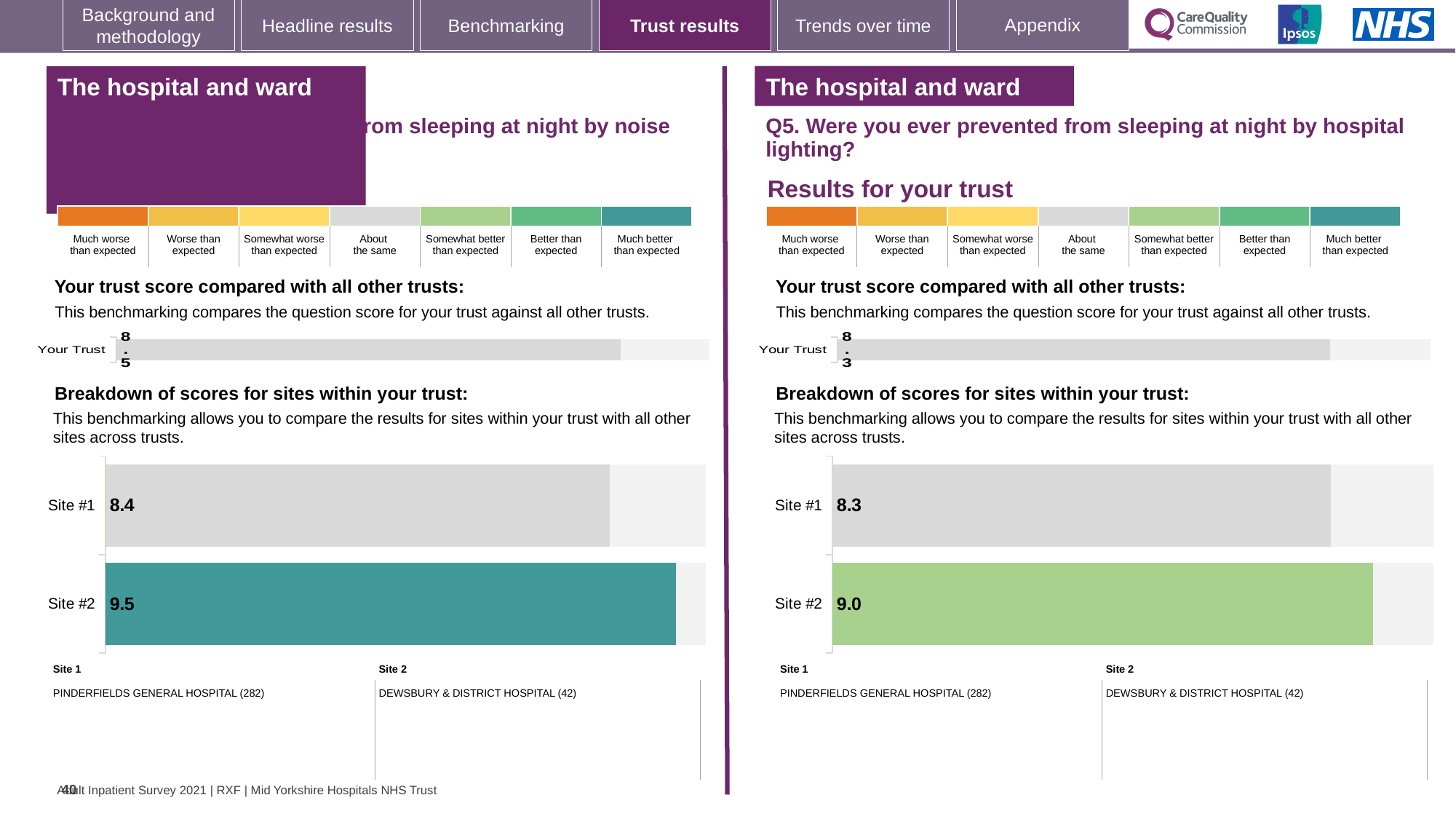
On the right-hand site breakdown chart (Q5, hospital lighting), what is the score for Site #2? 9.0 On the right-hand site breakdown chart (Q5, hospital lighting), which site has the lower score? Site #1 On the right-hand 'Your trust score compared with all other trusts' chart (Q5, hospital lighting), what is the Your Trust score? 8.3 On the left-hand site breakdown chart, what is the difference between the Site #2 and Site #1 scores? 1.1 On the right-hand site breakdown chart (Q5, hospital lighting), what is the score for Site #1? 8.3 On the left-hand site breakdown chart (sleeping at night by noise), what is the score for Site #2? 9.5 On the left-hand 'Your trust score compared with all other trusts' chart, what is the Your Trust score? 8.5 What type of chart is used for the site breakdown on the left-hand side of the slide? Bar chart How many sites are shown on the right-hand site breakdown chart (Q5, hospital lighting)? 2 On the right-hand site breakdown chart (Q5, hospital lighting), what is the difference between the Site #2 and Site #1 scores? 0.7 On the left-hand site breakdown chart (sleeping at night by noise), what is the score for Site #1? 8.4 On the left-hand site breakdown chart, which site has the higher score? Site #2